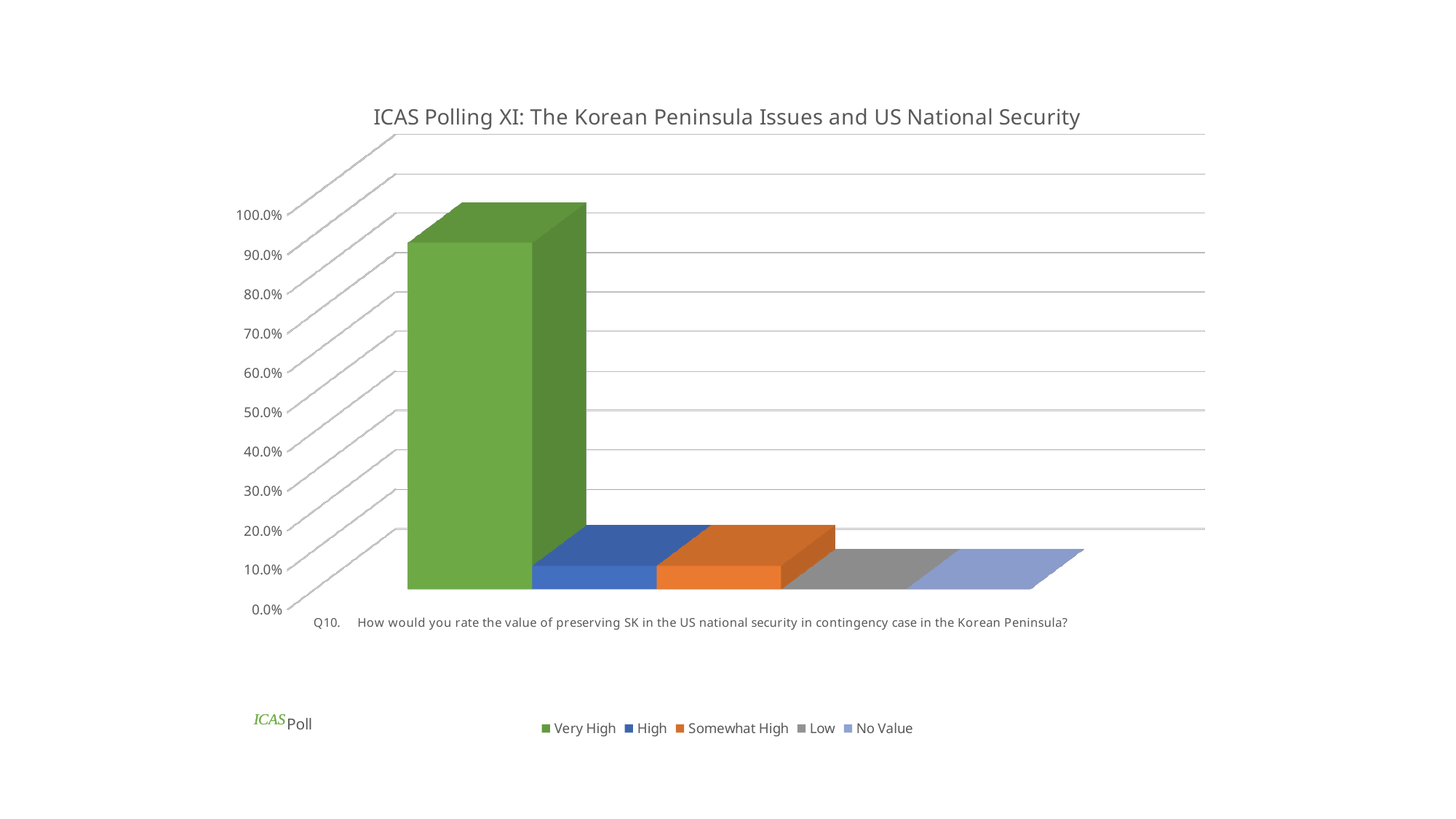
Which series is shown in orange? Somewhat High Is the value for Somewhat High greater or less than 20.0%? less What kind of chart is shown on the slide? bar chart What is the title of the chart? ICAS Polling XI: The Korean Peninsula Issues and US National Security Which is larger, the value for Very High or the value for High? Very High Is the value for High greater or less than 20.0%? less Which is larger, the value for Somewhat High or the value for Very High? Very High Is the value for Very High greater or less than 50.0%? greater How many series does the legend list? 5 Which series has the highest value? Very High